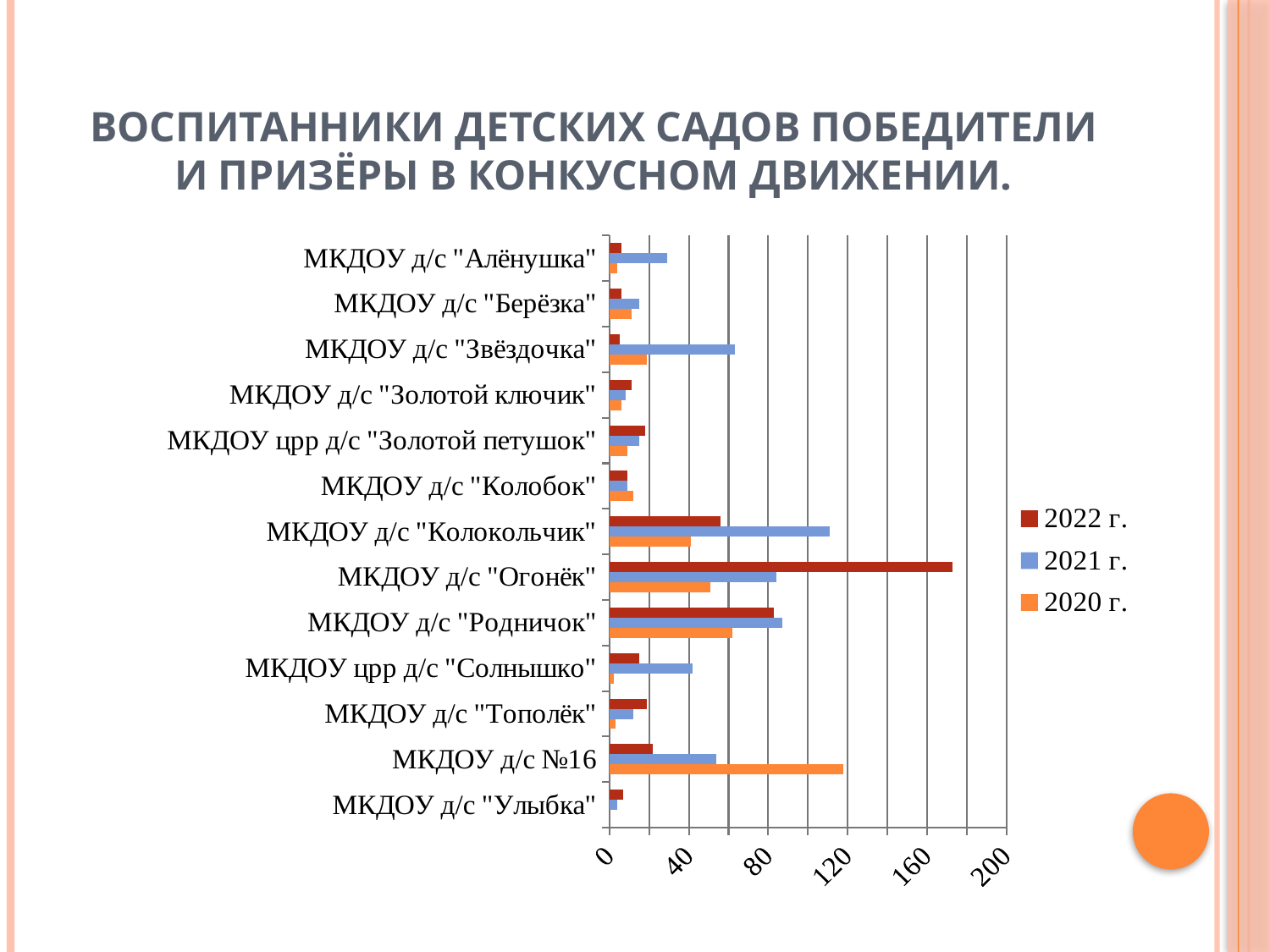
Which kindergarten has the highest value for 2020 г.? МКДОУ д/с №16 Which kindergarten has the highest value for 2022 г.? МКДОУ д/с "Огонёк" Is the 2021 г. value for МКДОУ д/с "Алёнушка" greater or less than 40? less Is the 2021 г. value for МКДОУ д/с "Звёздочка" greater or less than 80? less How many kindergartens (categories) are shown on the chart? 13 How many series does the legend list? 3 For МКДОУ д/с "Звёздочка", which is larger: the 2021 г. value or the 2022 г. value? 2021 г. Which kindergarten has the highest value for 2021 г.? МКДОУ д/с "Колокольчик" Is the 2021 г. value for МКДОУ д/с "Колокольчик" greater or less than 80? greater What kind of chart is shown on the slide? bar chart Which series is shown in orange in the legend? 2020 г.